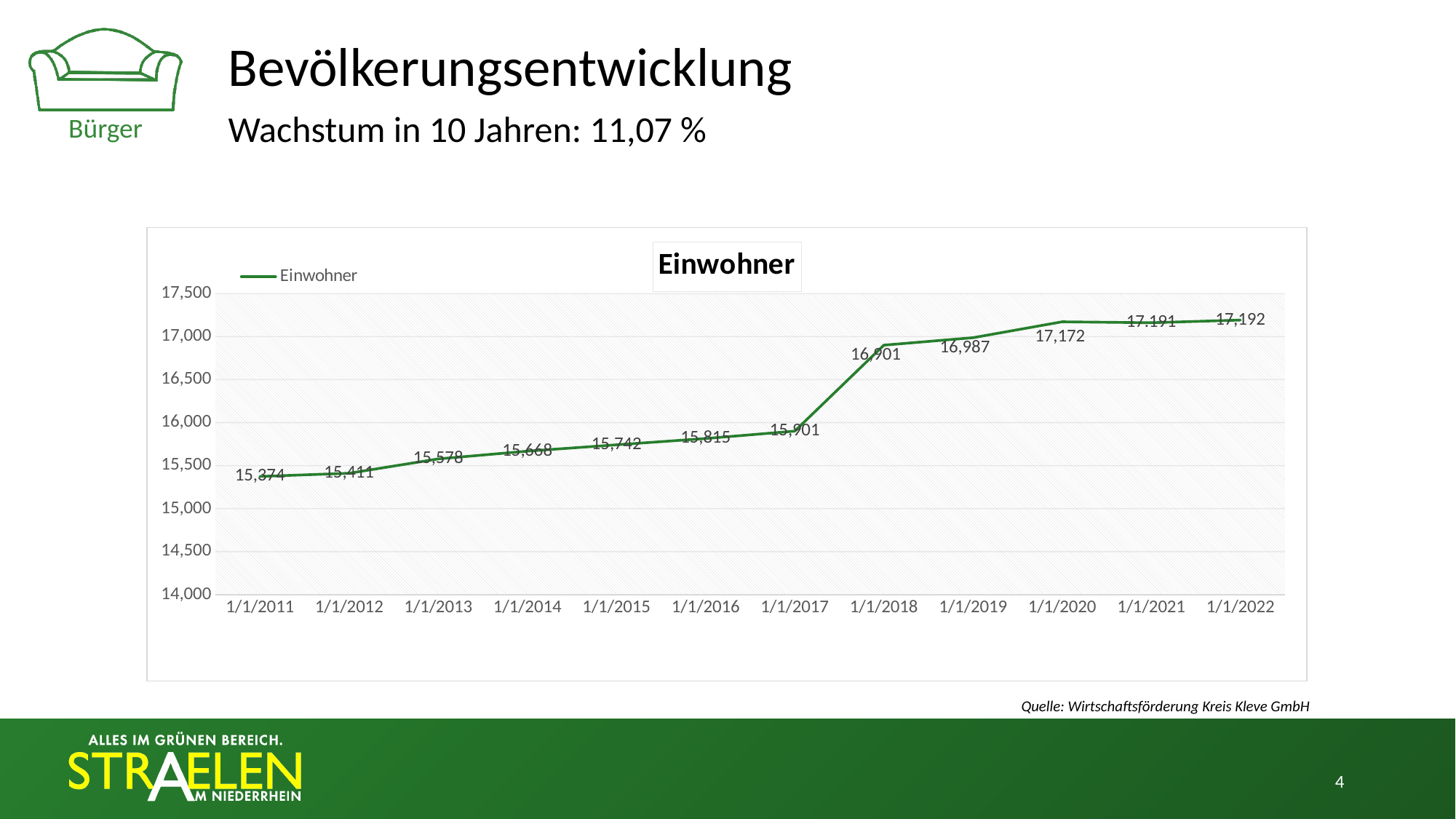
What kind of chart is shown on the slide? line chart What is the value for 1/1/2011 in the Einwohner chart? 15,374 What is the difference between the values for 1/1/2018 and 1/1/2017? 1,000 What is the value for 1/1/2018 in the Einwohner chart? 16,901 Which is larger, the value for 1/1/2016 or the value for 1/1/2019? 1/1/2019 Which date has the lowest value in the Einwohner chart? 1/1/2011 Is the value for 1/1/2020 greater or less than 17,000? greater What is the difference between the values for 1/1/2022 and 1/1/2011? 1,818 Do the values rise or fall from 1/1/2011 to 1/1/2022? rise How many data points are plotted in the Einwohner chart? 12 What is the value for 1/1/2022 in the Einwohner chart? 17,192 What is the value for 1/1/2015 in the Einwohner chart? 15,742